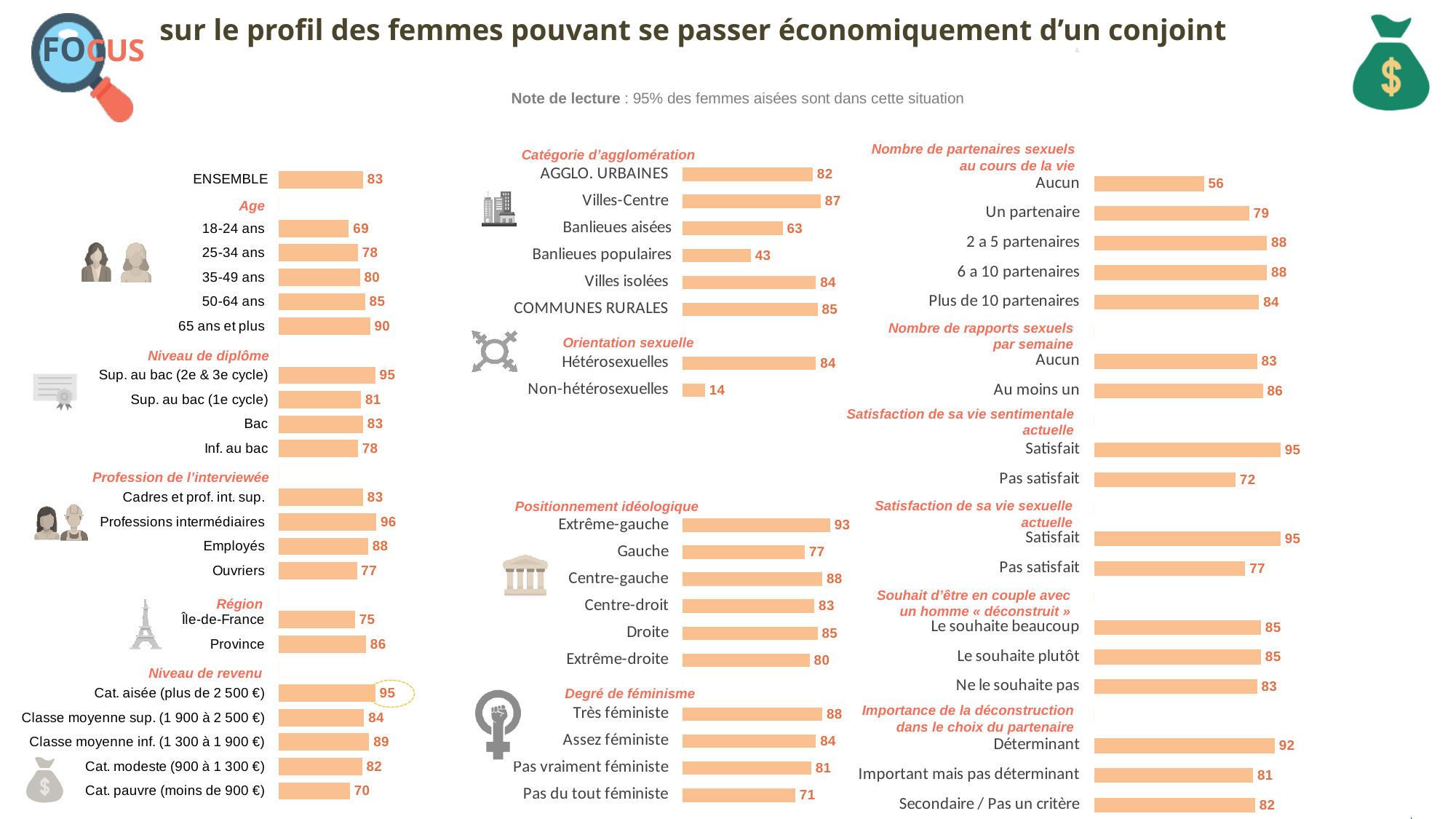
What kind of chart is used throughout the slide? Bar chart In the 'Catégorie d'agglomération' chart, which category has the lowest value? Banlieues populaires In the 'Profession de l'interviewée' chart, which category has the highest value? Professions intermédiaires In the 'Positionnement idéologique' chart, which category has the highest value? Extrême-gauche In the 'Age' chart, what is the value for '65 ans et plus'? 90 In the 'Nombre de partenaires sexuels au cours de la vie' chart, which is larger: 'Aucun' or 'Un partenaire'? Un partenaire In the 'Importance de la déconstruction dans le choix du partenaire' chart, what is the value for 'Déterminant'? 92 In the 'Région' chart, what is the value for 'Île-de-France'? 75 In the 'Niveau de revenu' chart, how many categories are shown? 5 In the 'Degré de féminisme' chart, what is the value for 'Pas du tout féministe'? 71 In the 'Orientation sexuelle' chart, what is the difference between 'Hétérosexuelles' and 'Non-hétérosexuelles'? 70 In the 'Satisfaction de sa vie sentimentale actuelle' chart, what is the difference between 'Satisfait' and 'Pas satisfait'? 23